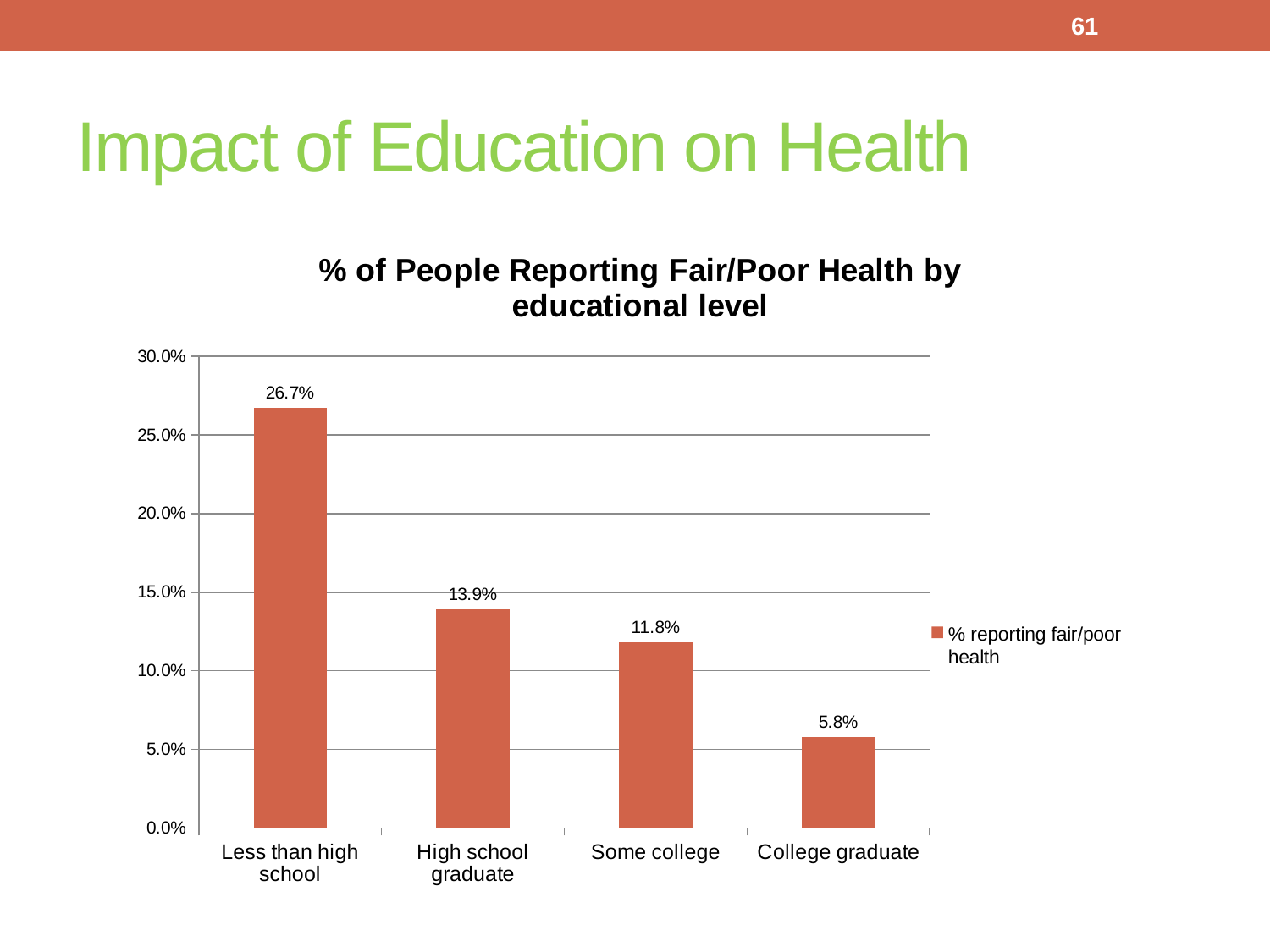
What is the value for College graduate? 5.8% What kind of chart is shown on the slide? Bar chart Do the values rise or fall from left to right along the x axis? Fall Which educational level has the lowest percentage reporting fair/poor health? College graduate How many series does the legend list? 1 What percentage of people with less than high school education report fair/poor health? 26.7% What is the value for High school graduate? 13.9% Which is larger, the value for High school graduate or Some college? High school graduate What is the value for Some college? 11.8% What is the difference between the values for Less than high school and College graduate? 20.9% How many educational levels are shown on the x axis? 4 Which educational level has the highest percentage reporting fair/poor health? Less than high school